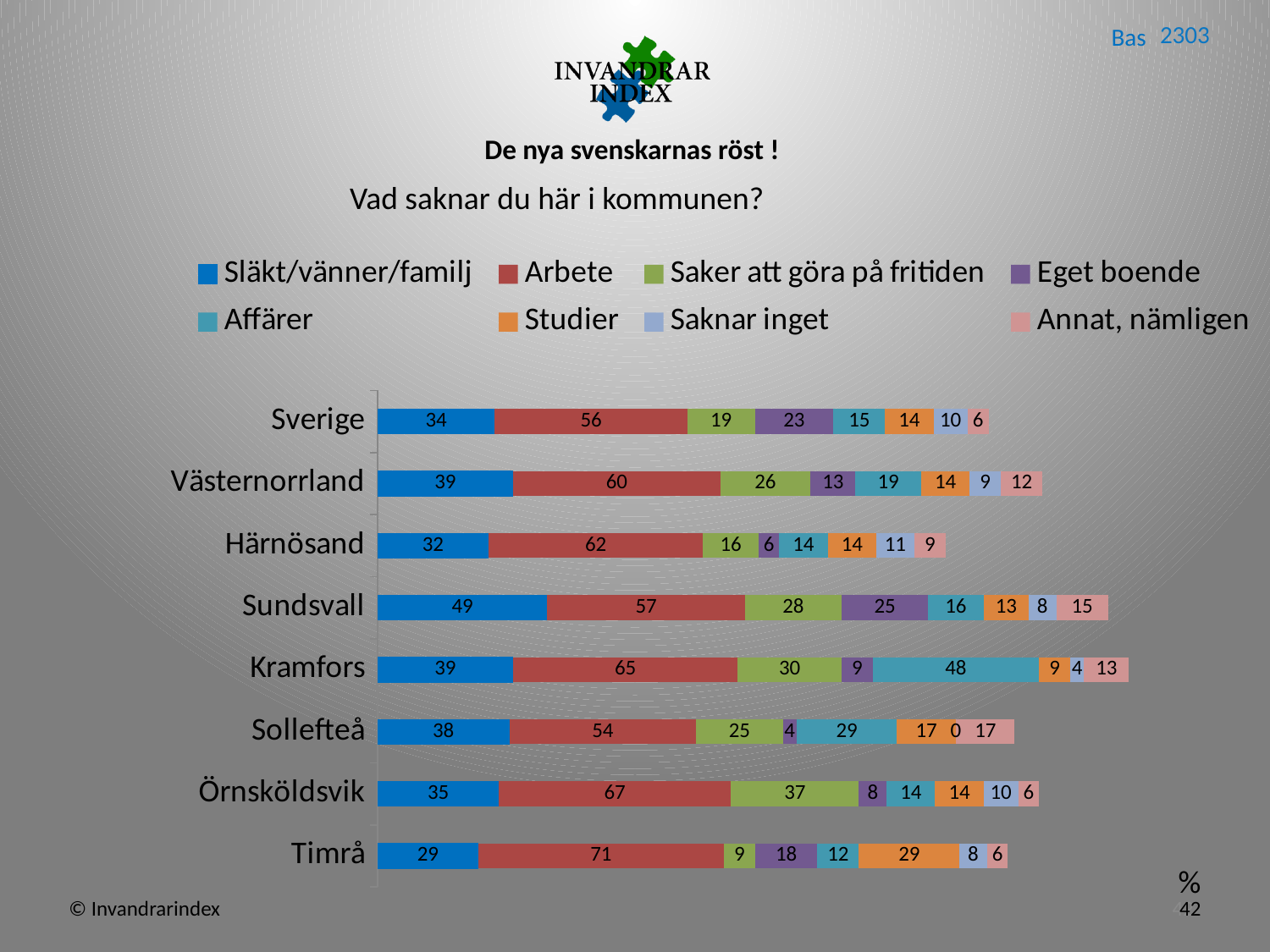
What is the total of the stacked bar for Timrå? 182 Which category has the highest value for Arbete? Timrå Which category has the lowest value for Släkt/vänner/familj? Timrå Which is larger, the Saker att göra på fritiden value for Örnsköldsvik or for Kramfors? Örnsköldsvik What is the value for Arbete for Timrå? 71 What is the difference between the Arbete values for Örnsköldsvik and Sverige? 11 What kind of chart is shown on the slide? Stacked bar chart What is the value for Saknar inget for Sollefteå? 0 How many categories are shown on the y axis? 8 What is the value for Affärer for Kramfors? 48 How many series does the legend list? 8 What is the value for Släkt/vänner/familj for Sundsvall? 49